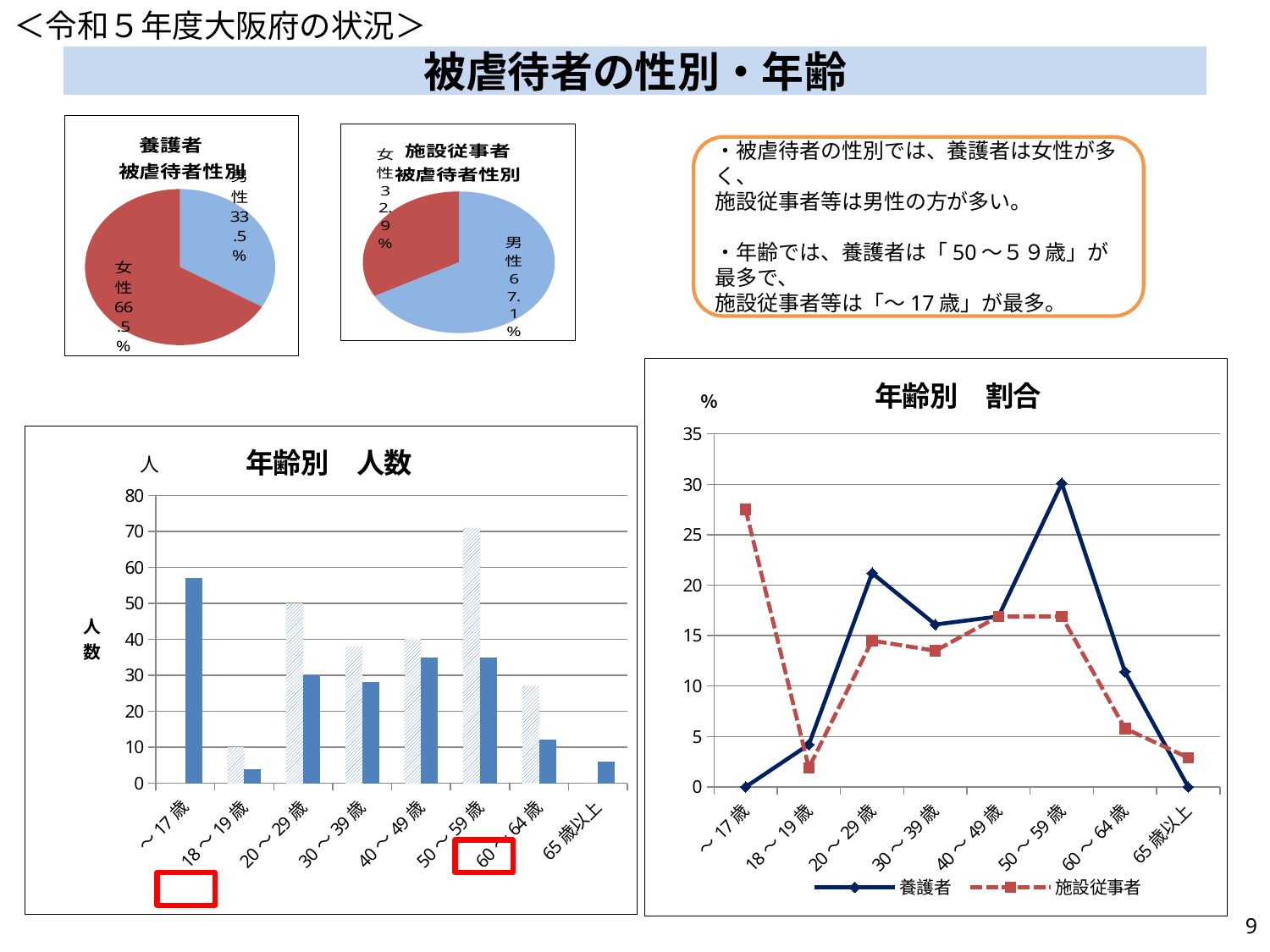
In the 年齢別 割合 chart, which age category has the highest value for 養護者? 50～59歳 In the 施設従事者 被虐待者性別 pie chart, what is the difference between the 男性 and 女性 shares? 34.2% What kind of chart is the 年齢別 割合 chart? line chart What kind of chart is the 養護者 被虐待者性別 chart? pie chart In the 年齢別 割合 chart, which age category has the highest value for 施設従事者? ～17歳 In the 養護者 被虐待者性別 pie chart, which is larger, 女性 or 男性? 女性 How many series does the legend of the 年齢別 割合 chart list? 2 How many age categories are shown on the x axis of the 年齢別 人数 chart? 8 In the 養護者 被虐待者性別 pie chart, what share is 女性? 66.5% In the 年齢別 割合 chart, is the 養護者 value for 50～59歳 greater or less than 25? greater In the 施設従事者 被虐待者性別 pie chart, what share is 男性? 67.1% In the 年齢別 人数 chart, is the solid blue bar for ～17歳 greater or less than 50? greater